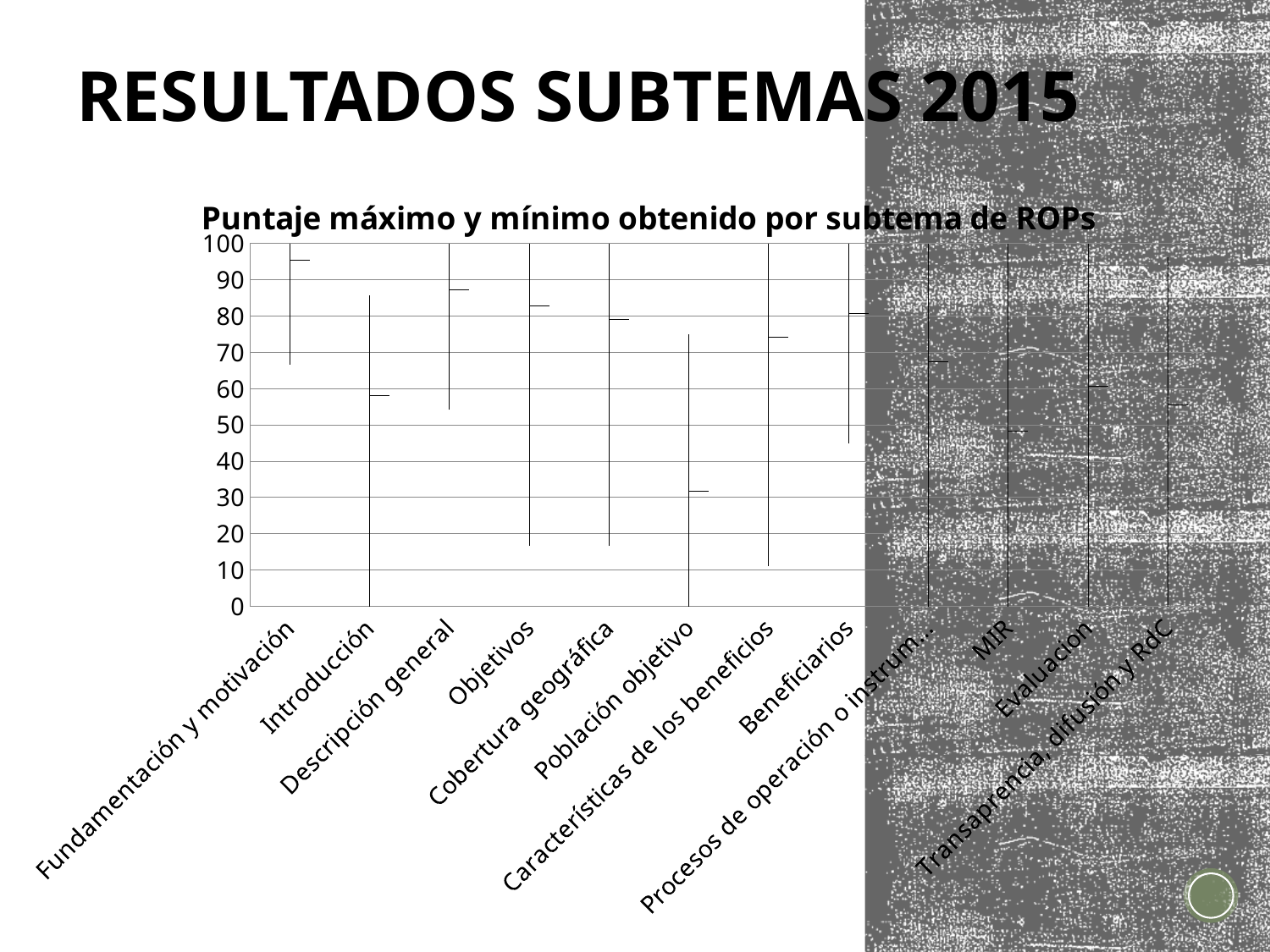
Is the marker value for Transparencia, difusión y RdC greater or less than 70? less Is the marker value for Población objetivo greater or less than 40? less How many subtemas (categories) are shown on the x axis of the chart? 12 Is the marker value for Fundamentación y motivación greater or less than 90? greater Which subtema has the highest marker value in the chart? Fundamentación y motivación Which subtema has the lowest marker value in the chart? Población objetivo What is the title of the chart? Puntaje máximo y mínimo obtenido por subtema de ROPs Which has the larger marker value, Descripción general or Población objetivo? Descripción general What is the maximum value shown on the vertical axis of the chart? 100